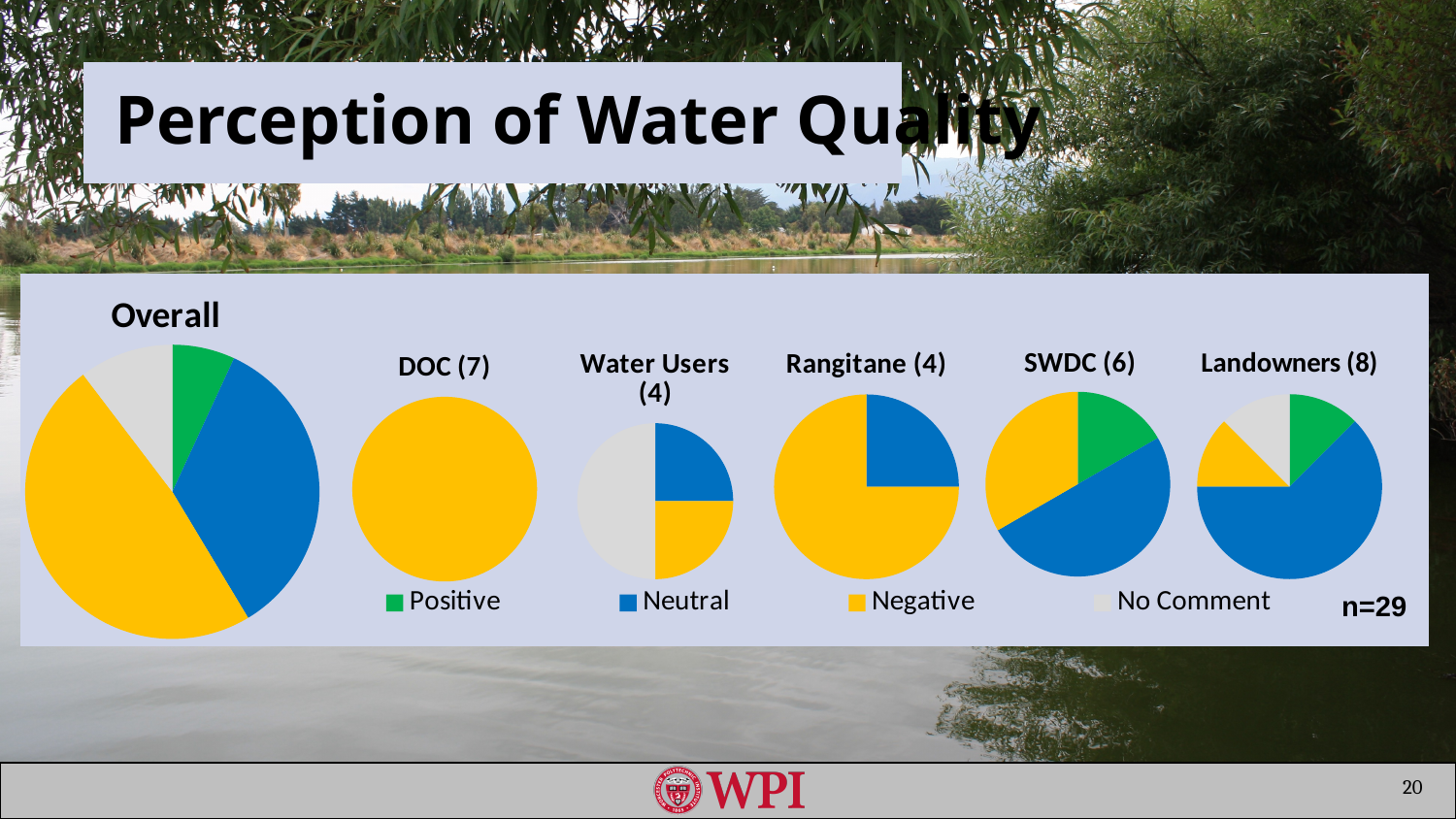
In the SWDC (6) pie chart, which category has the largest slice? Neutral In the Overall pie chart, which category has the largest slice? Negative In the Landowners (8) pie chart, which category has the largest slice? Neutral How many pie charts are shown on the slide? 6 How many categories does the legend list for the pie charts? 4 In the Overall pie chart, which category has the smallest slice? Positive What total sample size (n) is stated on the slide for the pie charts? n=29 What kind of chart is used on this slide to show perception of water quality? Pie chart In the Overall pie chart, which slice is larger, Negative or Neutral? Negative